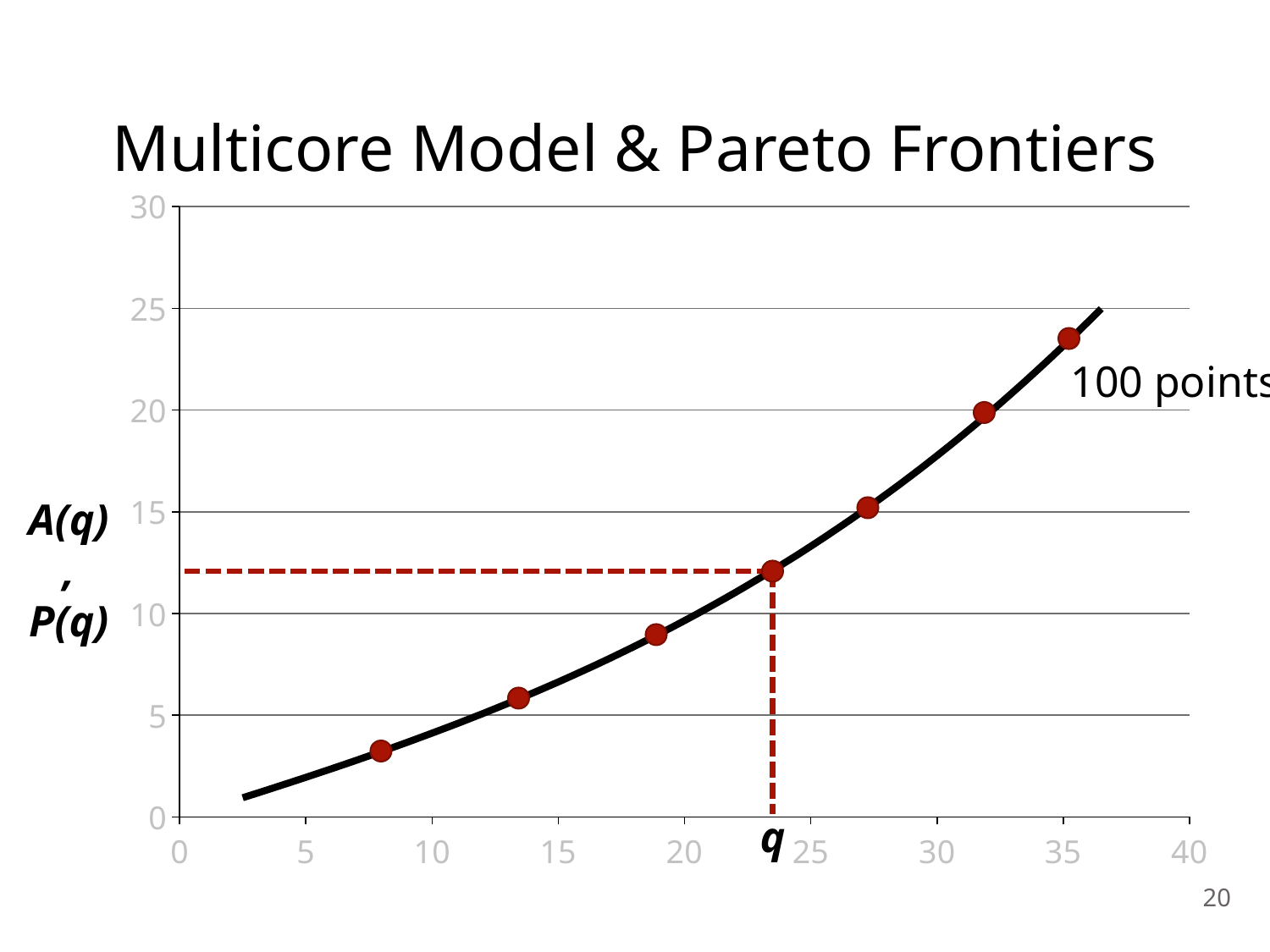
Which red marker point has the highest value, the leftmost or the rightmost? rightmost How many red marker points are plotted on the curve? 7 Is the value of the leftmost red marker point greater or less than 5? less Does the curve rise or fall as the x value increases? rises What is the title of the chart? Multicore Model & Pareto Frontiers What kind of chart is shown on the slide? line chart Is the value of the rightmost red marker point greater or less than 20? greater What is the maximum value shown on the y axis? 30 Is the value of the marked point at q (where the dashed lines meet the curve) greater or less than 15? less Is the value of the marked point at q greater or less than the value of the leftmost marked point? greater